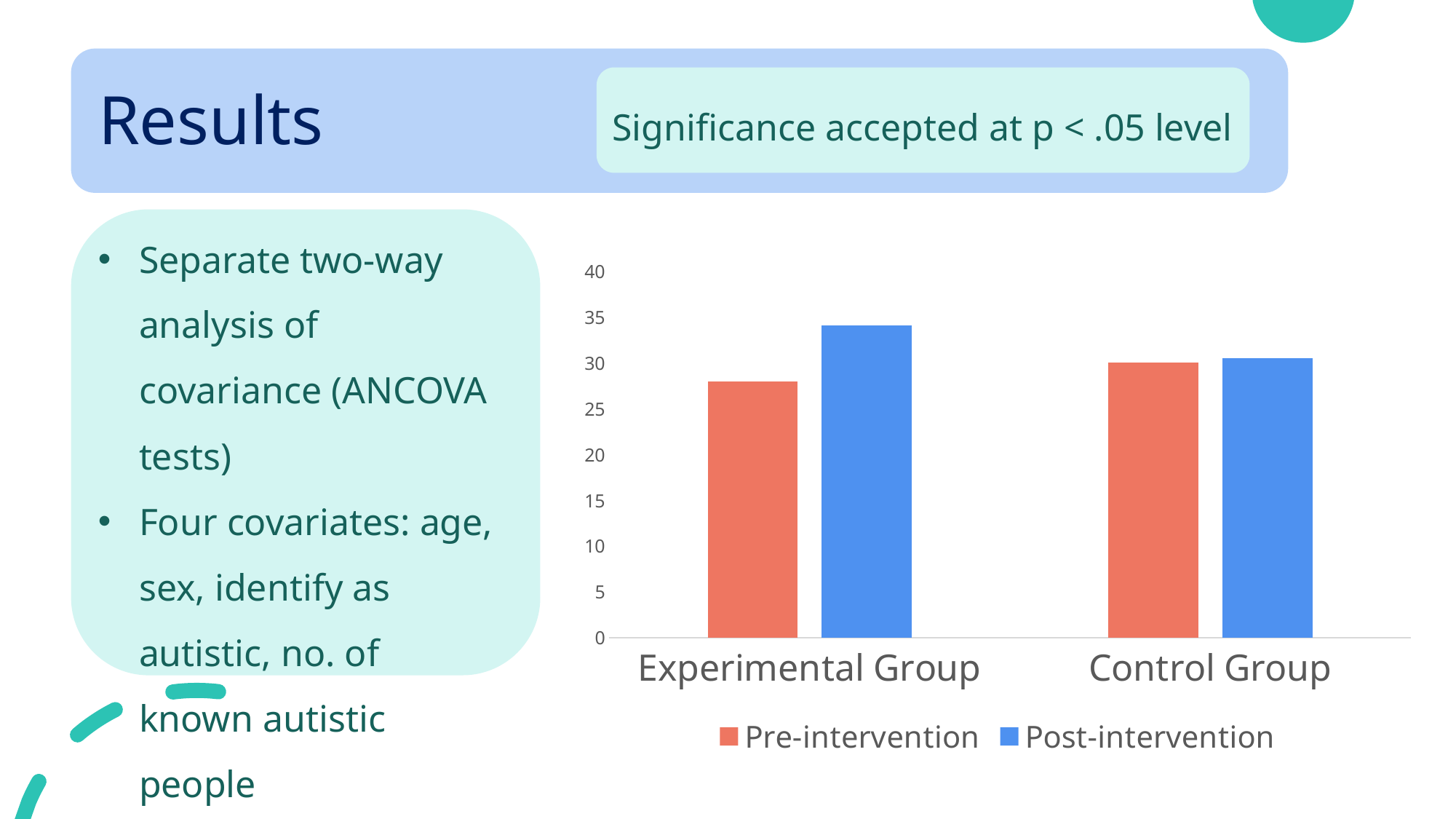
For the Experimental Group, which is larger: the Pre-intervention or the Post-intervention value? Post-intervention How many series does the chart's legend list? 2 Is the Post-intervention value for the Experimental Group greater or less than 30? greater How many groups are shown on the x axis of the chart? 2 Which series is shown in red/orange in the chart? Pre-intervention Which series is shown in blue in the chart? Post-intervention Is the Pre-intervention value for the Experimental Group greater or less than 30? less Which bar in the chart is the tallest? Experimental Group Post-intervention Is the Post-intervention value for the Experimental Group greater or less than 35? less What kind of chart is shown on the slide? bar chart